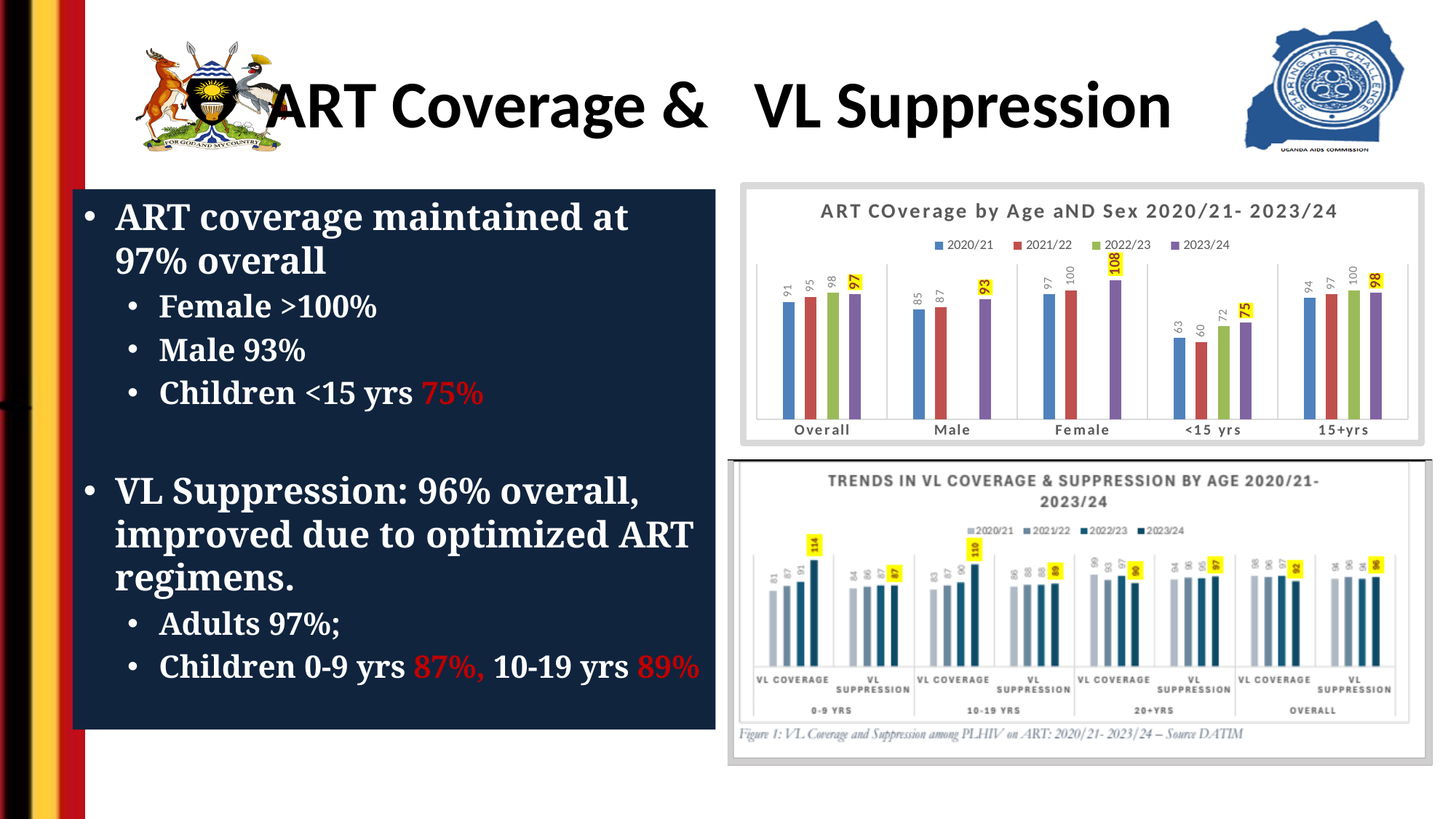
In the 'ART COverage by Age aND Sex' chart, what is the 2023/24 value for <15 yrs? 75 In the 'ART COverage by Age aND Sex' chart, what is the 2023/24 value for Female? 108 In the 'ART COverage by Age aND Sex' chart, how many series does the legend list? 4 In the 'ART COverage by Age aND Sex' chart, what is the 2020/21 value for Overall? 91 In the 'TRENDS IN VL COVERAGE & SUPPRESSION BY AGE' chart, what is the 2023/24 VL suppression value for 10-19 yrs? 89 In the 'TRENDS IN VL COVERAGE & SUPPRESSION BY AGE' chart, what is the 2023/24 VL coverage value for 0-9 yrs? 114 In the 'ART COverage by Age aND Sex' chart, which category has the highest 2023/24 value? Female What kind of chart is the 'TRENDS IN VL COVERAGE & SUPPRESSION BY AGE' chart? bar chart In the 'ART COverage by Age aND Sex' chart, which category has the lowest 2023/24 value? <15 yrs In the 'ART COverage by Age aND Sex' chart, do the values for <15 yrs rise or fall from 2021/22 to 2023/24? rise In the 'ART COverage by Age aND Sex' chart, how many categories are shown on the x axis? 5 In the 'ART COverage by Age aND Sex' chart, what is the difference between the 2023/24 and 2020/21 values for Male? 8